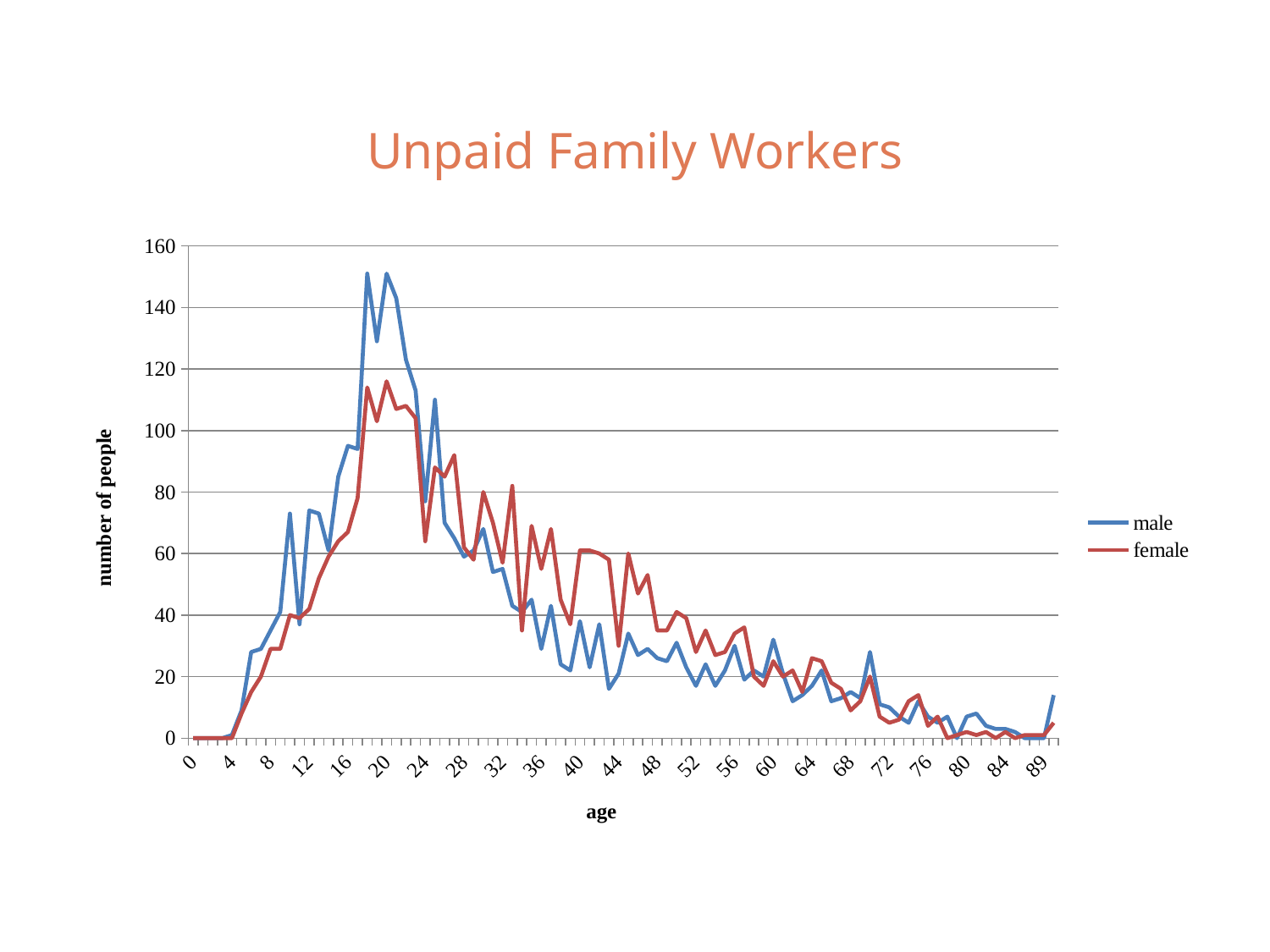
Which series reaches the highest peak on the chart? male Is the female value at age 4 greater or less than 20? less At age 36, which series has the higher value, male or female? female What is the title of the chart? Unpaid Family Workers What are the two series named in the legend? male and female Is the male value at age 20 greater or less than 140? greater At age 20, which series has the higher value, male or female? male Is the male value at age 8 greater or less than 20? greater How many series does the legend list? 2 What kind of chart is shown on the slide? line chart